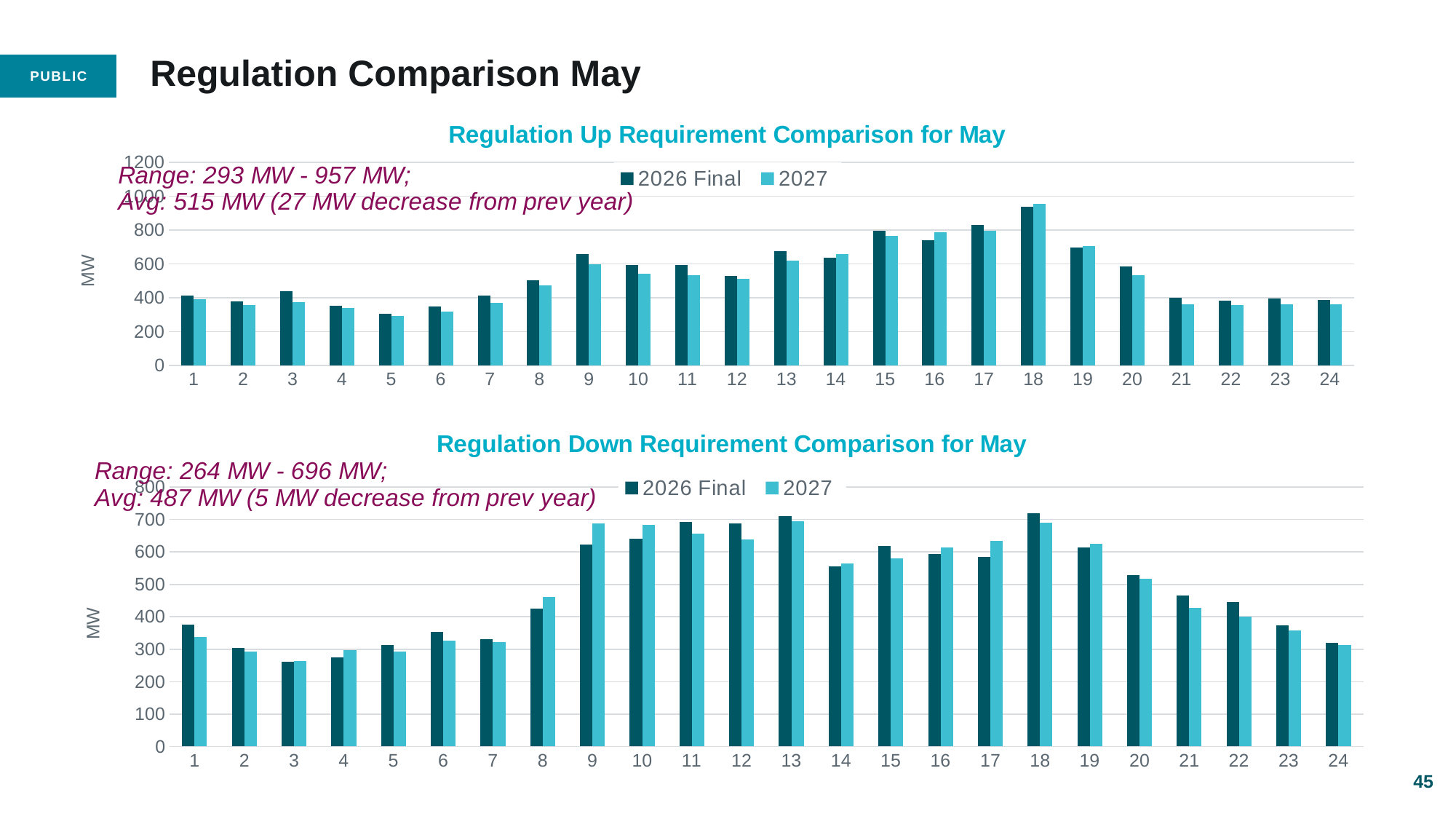
In the Regulation Up Requirement Comparison for May chart, do the 2026 Final values rise or fall from hour 18 to hour 21? fall In the Regulation Up Requirement Comparison for May chart, at which hour is the 2027 value highest? 18 In the Regulation Up Requirement Comparison for May chart, at hour 16, which series has the larger value, 2026 Final or 2027? 2027 How many series does the legend list in the Regulation Down Requirement Comparison for May chart? 2 How many hour categories are shown on the x axis of the Regulation Up Requirement Comparison for May chart? 24 In the Regulation Down Requirement Comparison for May chart, at hour 1, which series has the larger value, 2026 Final or 2027? 2026 Final In the Regulation Up Requirement Comparison for May chart, is the 2026 Final value at hour 9 greater or less than 600? greater In the Regulation Down Requirement Comparison for May chart, at which hour is the 2026 Final value lowest? 3 In the Regulation Down Requirement Comparison for May chart, is the 2027 value at hour 8 greater or less than 400? greater In the Regulation Down Requirement Comparison for May chart, at which hour is the 2026 Final value highest? 18 In the Regulation Up Requirement Comparison for May chart, at which hour is the 2027 value lowest? 5 What type of chart is the Regulation Up Requirement Comparison for May? bar chart